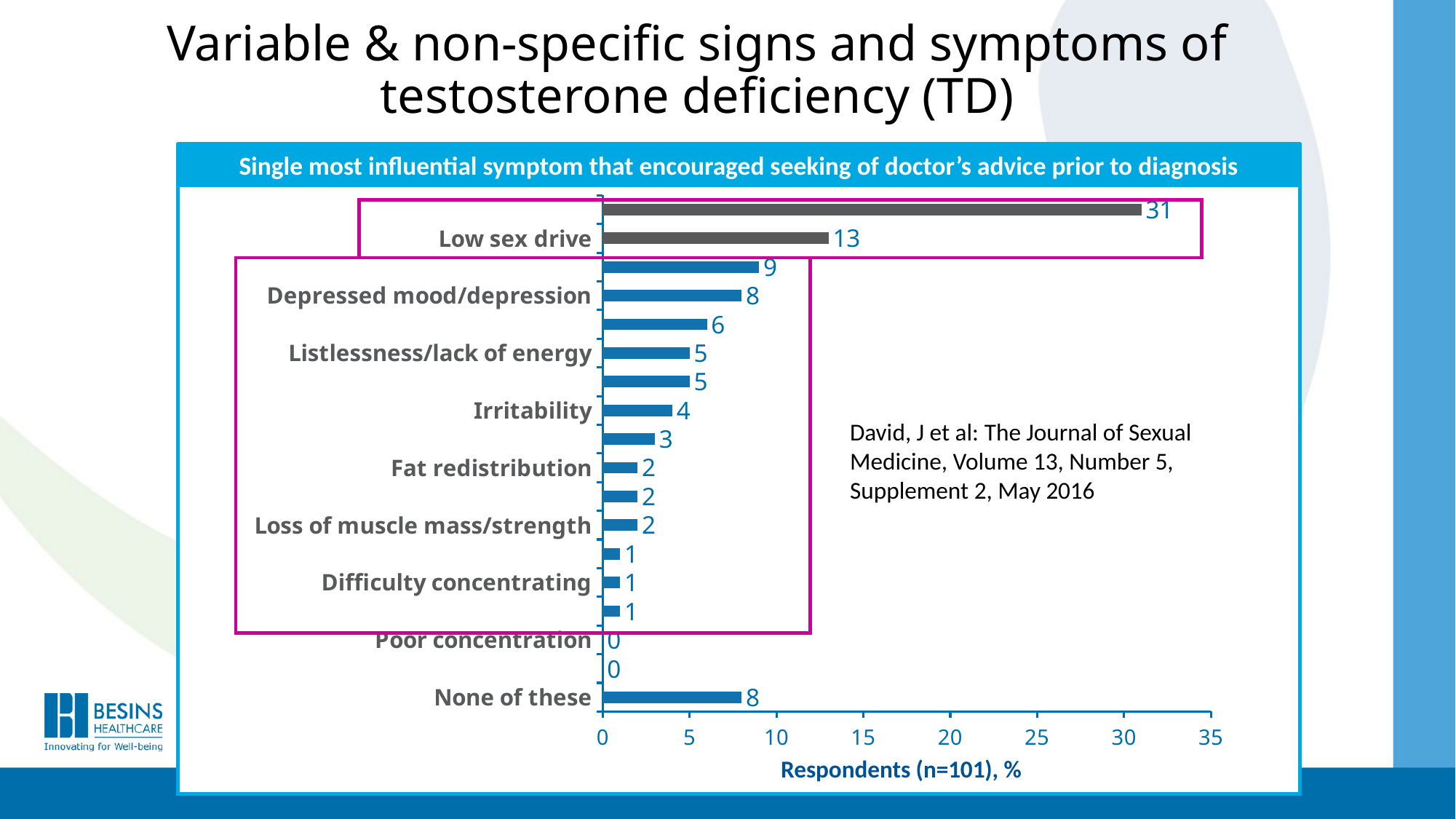
What is the value for Depressed mood/depression? 8 What is the value for Low sex drive? 13 What is the value for Difficulty concentrating? 1 What is the value for Irritability? 4 What is the title of the x axis of the chart? Respondents (n=101), % Which is larger, the value for Depressed mood/depression or the value for Listlessness/lack of energy? Depressed mood/depression What kind of chart is shown on the slide? bar chart What is the value for None of these? 8 What is the value for Listlessness/lack of energy? 5 Is the value for Low sex drive greater or less than 10? greater What is the difference between the values for Low sex drive and Irritability? 9 What is the value for Poor concentration? 0